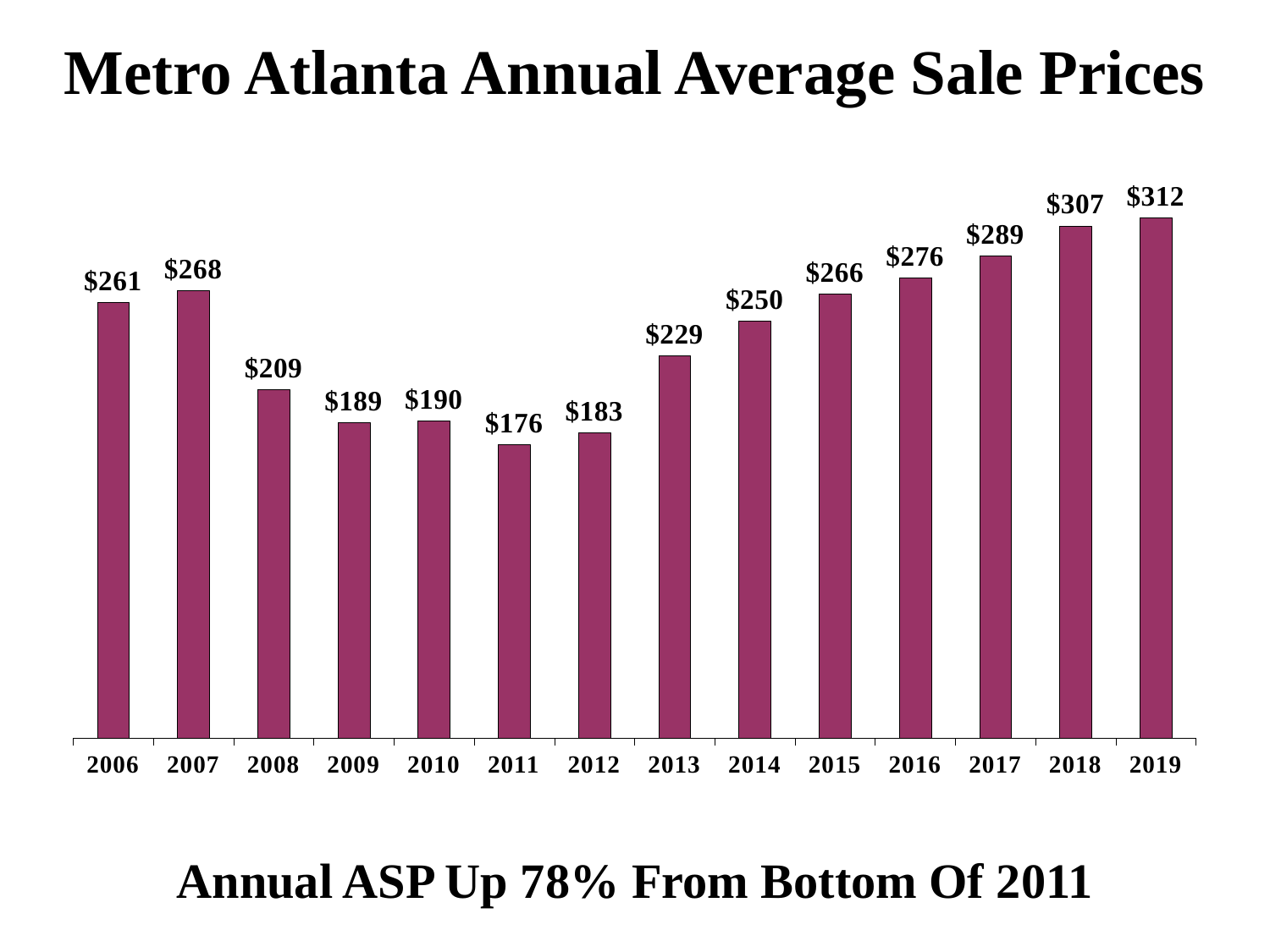
What is the average sale price shown for 2011? $176 How many years are shown on the chart? 14 What is the difference between the 2019 and 2011 average sale prices? $136 Which year has a higher average sale price, 2006 or 2007? 2007 Do the average sale prices rise or fall from 2011 to 2019? Rise Which year has the highest average sale price? 2019 What kind of chart is shown on the slide? Bar chart What is the title of the chart? Metro Atlanta Annual Average Sale Prices Which year has the lowest average sale price? 2011 What is the difference between the 2007 and 2008 average sale prices? $59 What is the average sale price shown for 2014? $250 What is the average sale price shown for 2019? $312